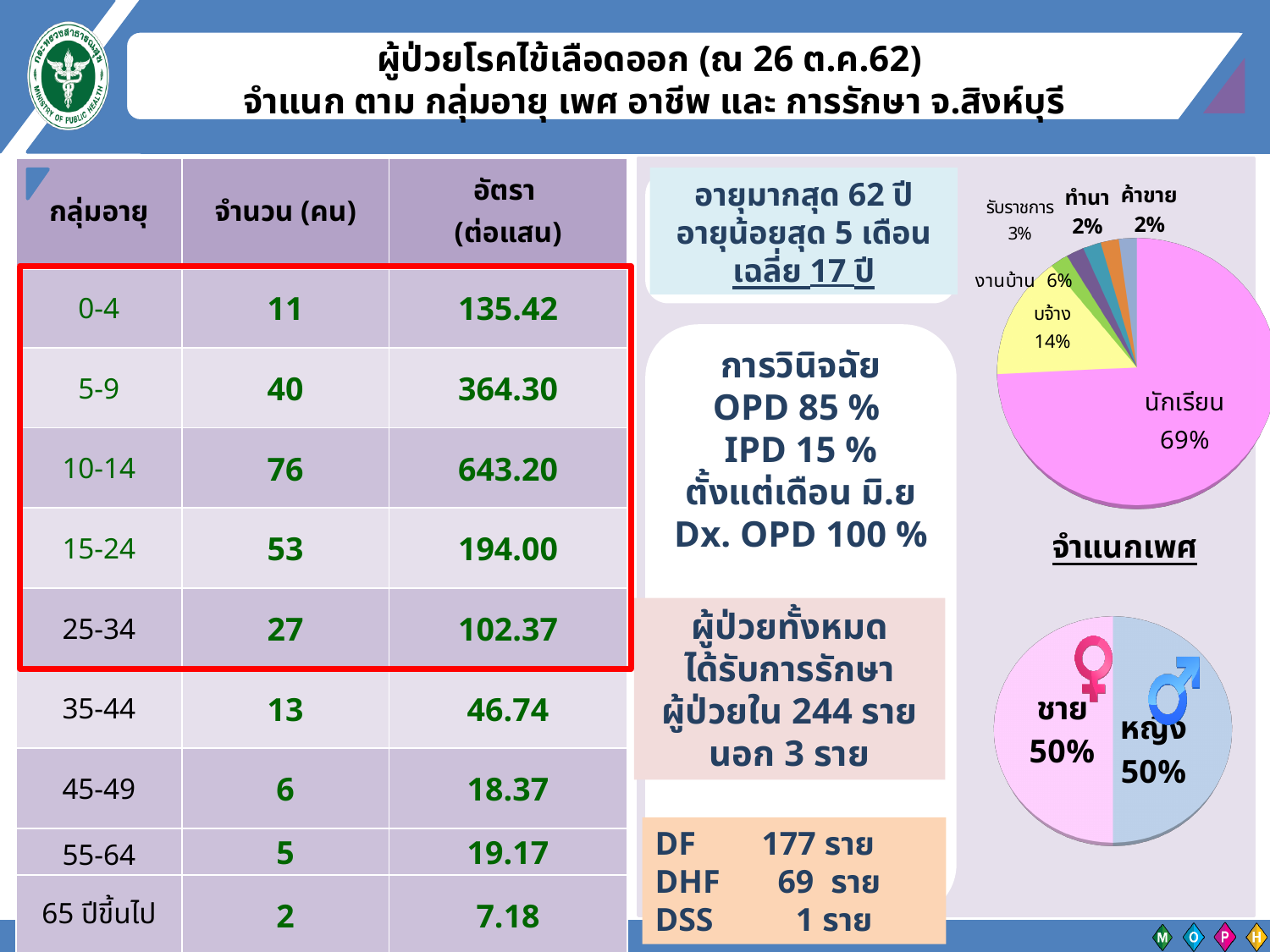
In the occupation pie chart at the top right, what share is labelled for รับจ้าง? 14% In the occupation pie chart at the top right, what is the difference in percentage points between นักเรียน and รับจ้าง? 55% In the occupation pie chart at the top right, what share is labelled for งานบ้าน? 6% In the occupation pie chart at the top right, what share is labelled for รับราชการ? 3% In the occupation pie chart at the top right, which slice is larger, งานบ้าน or รับราชการ? งานบ้าน What kind of chart is the occupation chart at the top right of the slide? pie chart What kind of chart is the gender chart at the bottom right of the slide? pie chart In the occupation pie chart at the top right, which category has the largest slice? นักเรียน In the gender chart (จำแนกเพศ) at the bottom right, how many slices does the pie have? 2 What is the title written above the gender pie chart at the bottom right? จำแนกเพศ